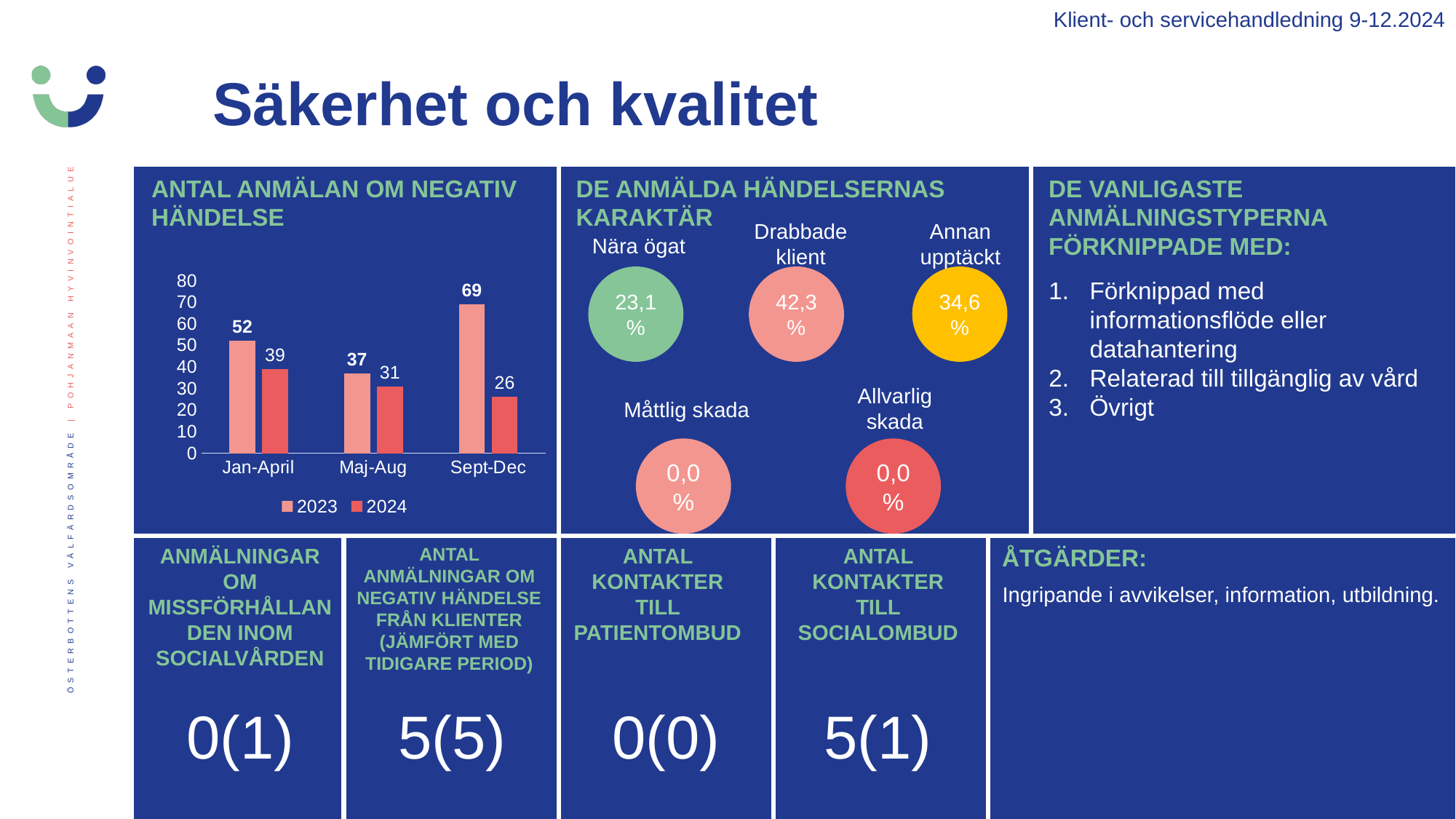
In the chart 'Antal anmälan om negativ händelse', which is larger in Jan-April: 2023 or 2024? 2023 In the chart 'Antal anmälan om negativ händelse', which period has the highest value for 2023? Sept-Dec In the chart 'Antal anmälan om negativ händelse', is the value for 2023 in Maj-Aug greater or less than 40? less In the chart 'Antal anmälan om negativ händelse', which period has the lowest value for 2024? Sept-Dec In the chart 'Antal anmälan om negativ händelse', what is the value for 2024 in Maj-Aug? 31 How many periods are shown on the x axis of the chart 'Antal anmälan om negativ händelse'? 3 In the chart 'Antal anmälan om negativ händelse', do the 2024 values rise or fall from Jan-April to Sept-Dec? Fall What kind of chart is 'Antal anmälan om negativ händelse'? Bar chart In the chart 'Antal anmälan om negativ händelse', what is the value for 2023 in Jan-April? 52 In the chart 'Antal anmälan om negativ händelse', what is the difference between the 2023 and 2024 values in Sept-Dec? 43 How many series does the legend of the chart 'Antal anmälan om negativ händelse' list? 2 In the chart 'Antal anmälan om negativ händelse', what is the value for 2024 in Sept-Dec? 26